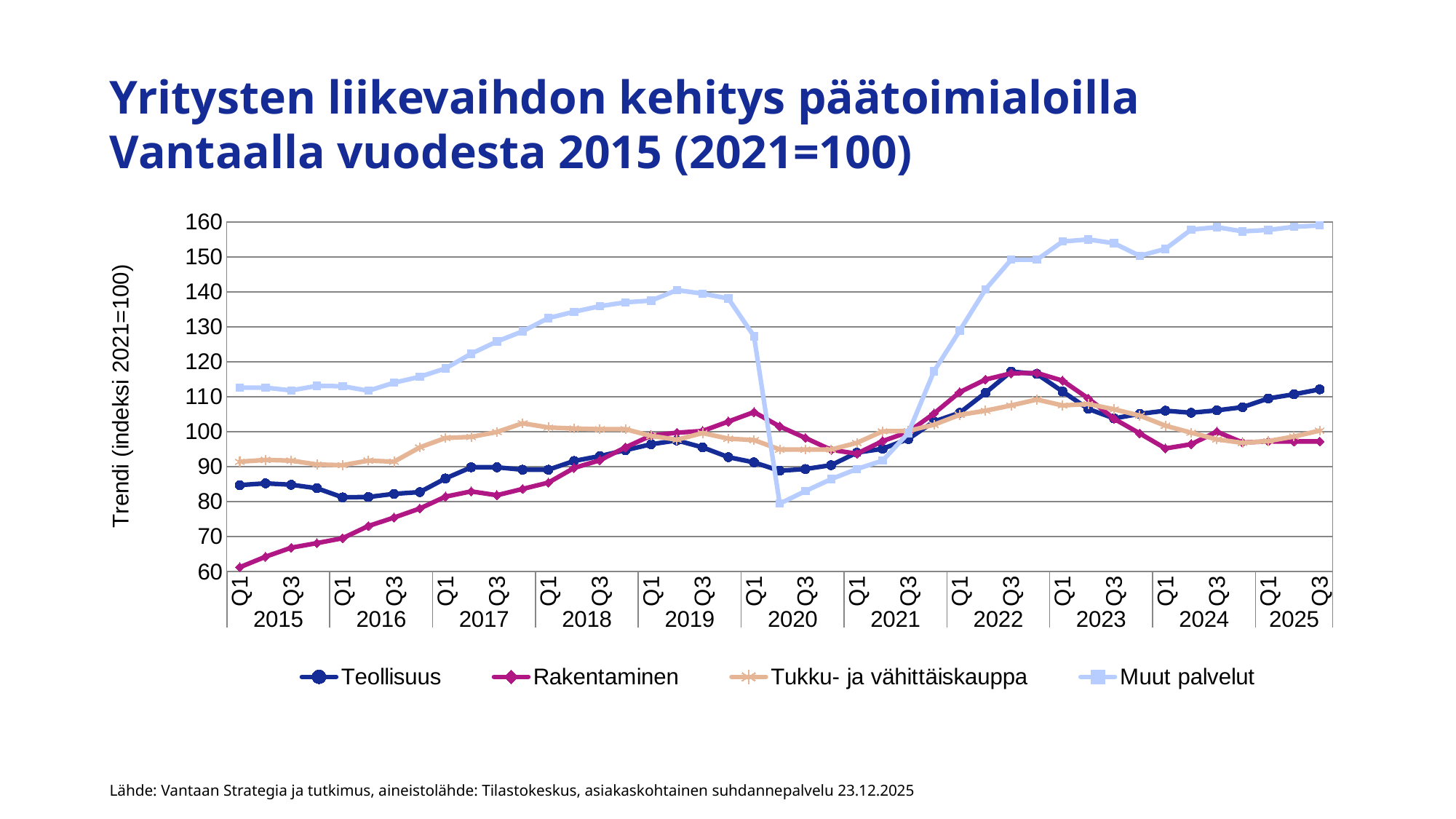
How many series does the legend list? 4 Does the Rakentaminen series rise or fall from Q1 2015 to Q1 2018? rise In Q3 2025, which is higher, Teollisuus or Rakentaminen? Teollisuus What is the title of the vertical axis? Trendi (indeksi 2021=100) Which series are listed in the legend? Teollisuus, Rakentaminen, Tukku- ja vähittäiskauppa, Muut palvelut Is the value for Muut palvelut in Q3 2025 greater or less than 150? greater Is the value for Muut palvelut in Q2 2020 greater or less than 90? less Which series has the highest value in Q3 2025? Muut palvelut Is the value for Teollisuus in Q3 2022 greater or less than 110? greater What kind of chart is shown on the slide? line chart Which series has the lowest value in Q1 2015? Rakentaminen